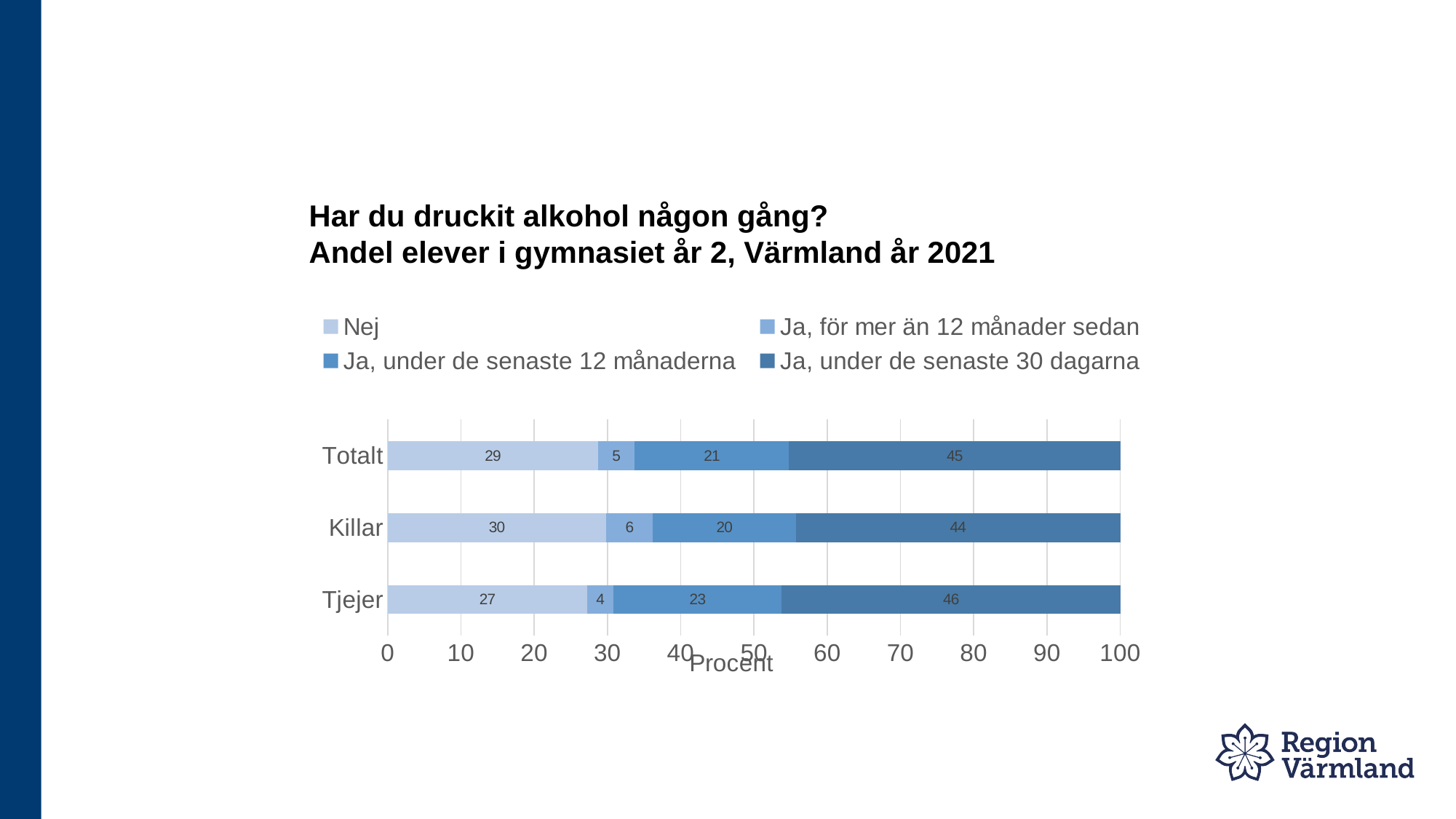
What is the total of the stacked bar for Killar? 100 Which is larger: the "Ja, under de senaste 12 månaderna" value for Killar or for Tjejer? Tjejer What is the value for "Ja, under de senaste 12 månaderna" for Tjejer? 23 What kind of chart is shown on the slide? Stacked bar chart Which category has the highest value for "Nej"? Killar What is the value for "Ja, under de senaste 30 dagarna" for Tjejer? 46 What is the value for "Ja, för mer än 12 månader sedan" for Killar? 6 What is the value for "Nej" for Totalt? 29 How many categories are shown on the y axis? 3 What is the difference between the "Ja, under de senaste 30 dagarna" values for Tjejer and Killar? 2 How many series does the legend list? 4 Which category has the lowest value for "Ja, för mer än 12 månader sedan"? Tjejer